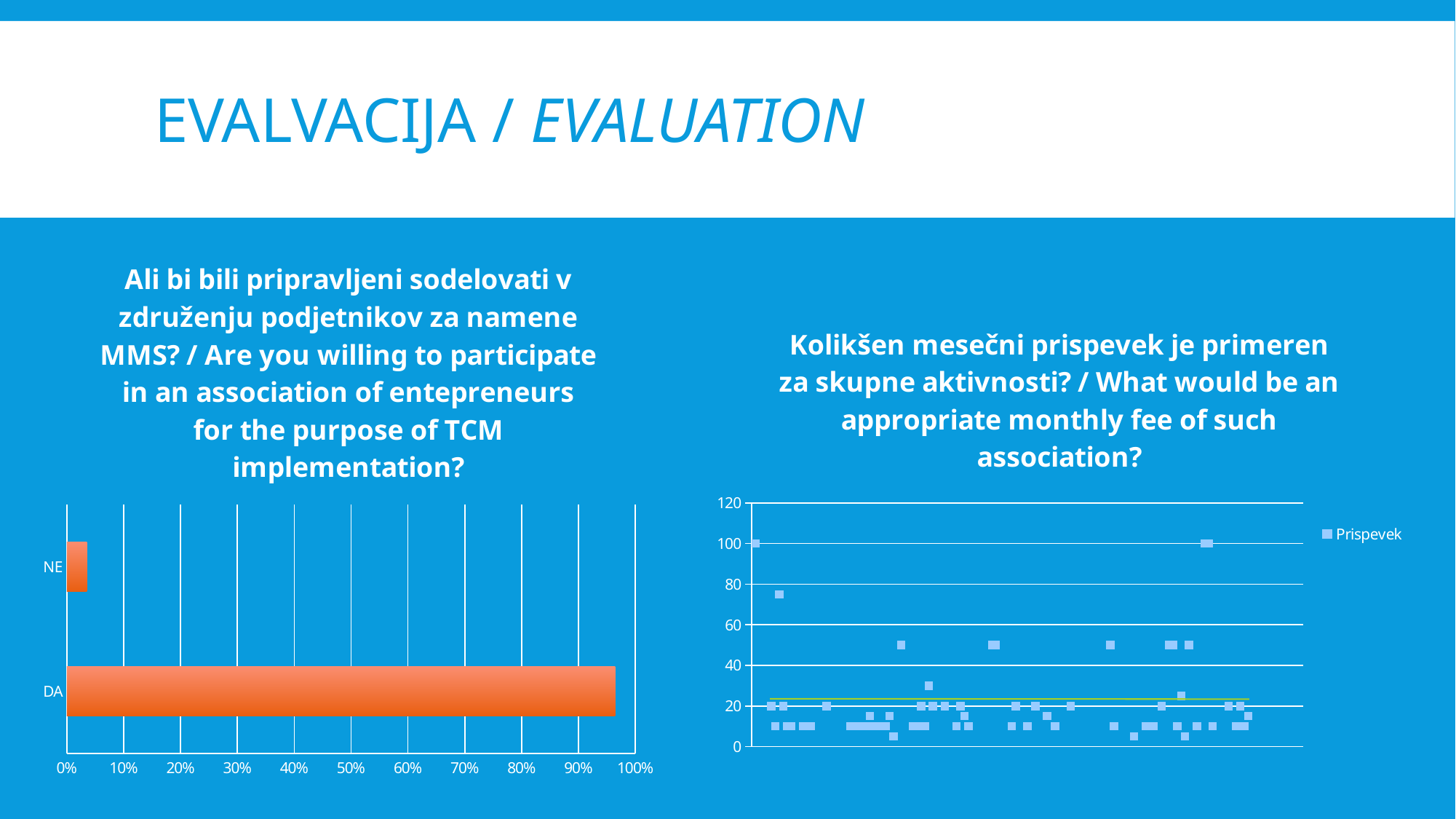
In the left chart (willingness to participate), which category has the lowest value? NE How many categories does the left chart (willingness to participate) show? 2 In the left chart (willingness to participate), is the value for NE greater or less than 10%? less In the left chart (willingness to participate), which category has the highest value? DA What is the highest value shown on the x axis of the left chart (willingness to participate)? 100% In the left chart (willingness to participate), which is larger, the value for DA or the value for NE? DA What kind of chart is the left chart, about willingness to participate in an association of entrepreneurs? bar chart In the right chart (appropriate monthly fee), is the highest plotted point greater or less than 80? greater What kind of chart is the right chart, about the appropriate monthly fee? scatter chart What is the name of the series in the legend of the right chart (appropriate monthly fee)? Prispevek In the left chart (willingness to participate), is the value for DA greater or less than 90%? greater How many series does the legend of the right chart (appropriate monthly fee) list? 1